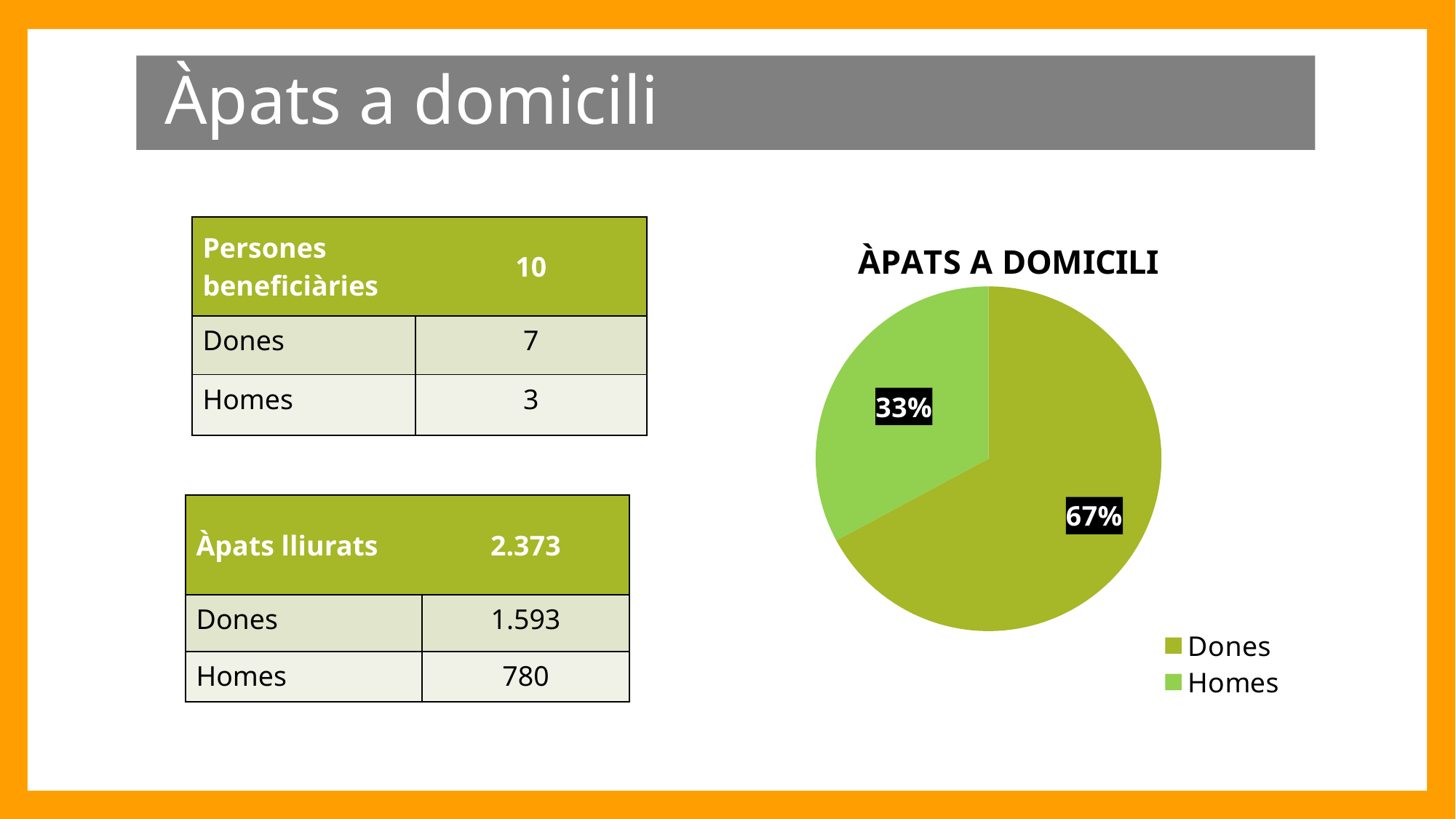
Which is larger in the pie chart, the Dones slice or the Homes slice? Dones What share of the pie chart does Dones represent? 67% What is the title of the pie chart? ÀPATS A DOMICILI Is the Homes share in the pie chart greater or less than 50%? less Which legend entry in the pie chart is shown in the lighter green colour? Homes Which slice of the pie chart is the smallest? Homes What is the difference in percentage points between the Dones and Homes slices of the pie chart? 34 What kind of chart is shown on the slide? pie chart Which slice of the pie chart is the largest? Dones How many slices does the pie chart have? 2 What share of the pie chart does Homes represent? 33% How many entries does the pie chart legend list? 2